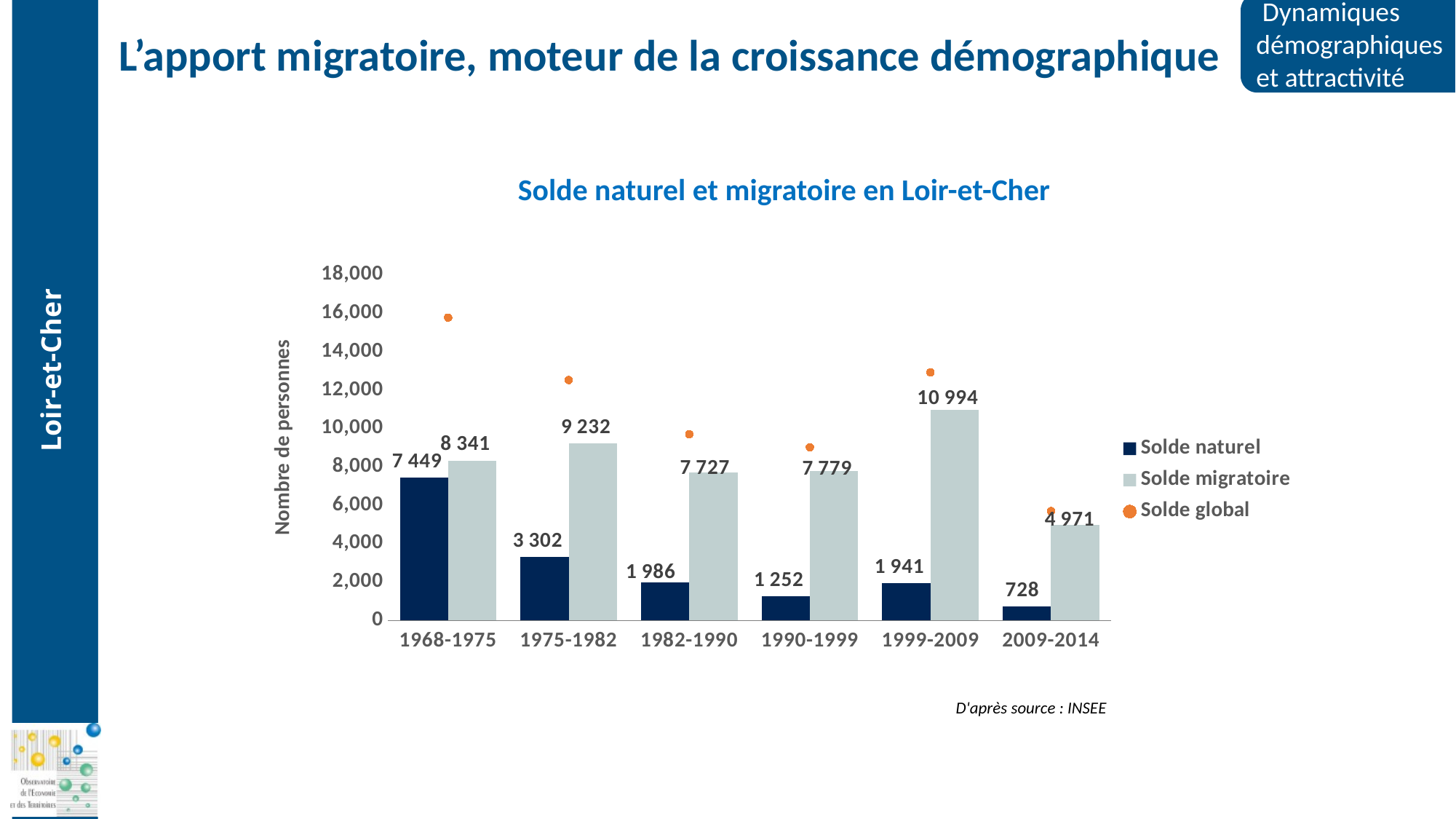
How many series does the legend list? 3 Which period has the lowest Solde naturel? 2009-2014 What is the value of Solde naturel for 1968-1975? 7 449 Which is larger in 1975-1982, Solde naturel or Solde migratoire? Solde migratoire What is the difference between Solde migratoire and Solde naturel in 1999-2009? 9 053 What is the title of the chart? Solde naturel et migratoire en Loir-et-Cher What is the value of Solde naturel for 2009-2014? 728 How many periods are shown on the x axis? 6 What is the difference between Solde migratoire and Solde naturel in 1968-1975? 892 What is the value of Solde migratoire for 1999-2009? 10 994 Is the Solde global value for 1968-1975 greater or less than 14,000? greater Which period has the highest Solde migratoire? 1999-2009